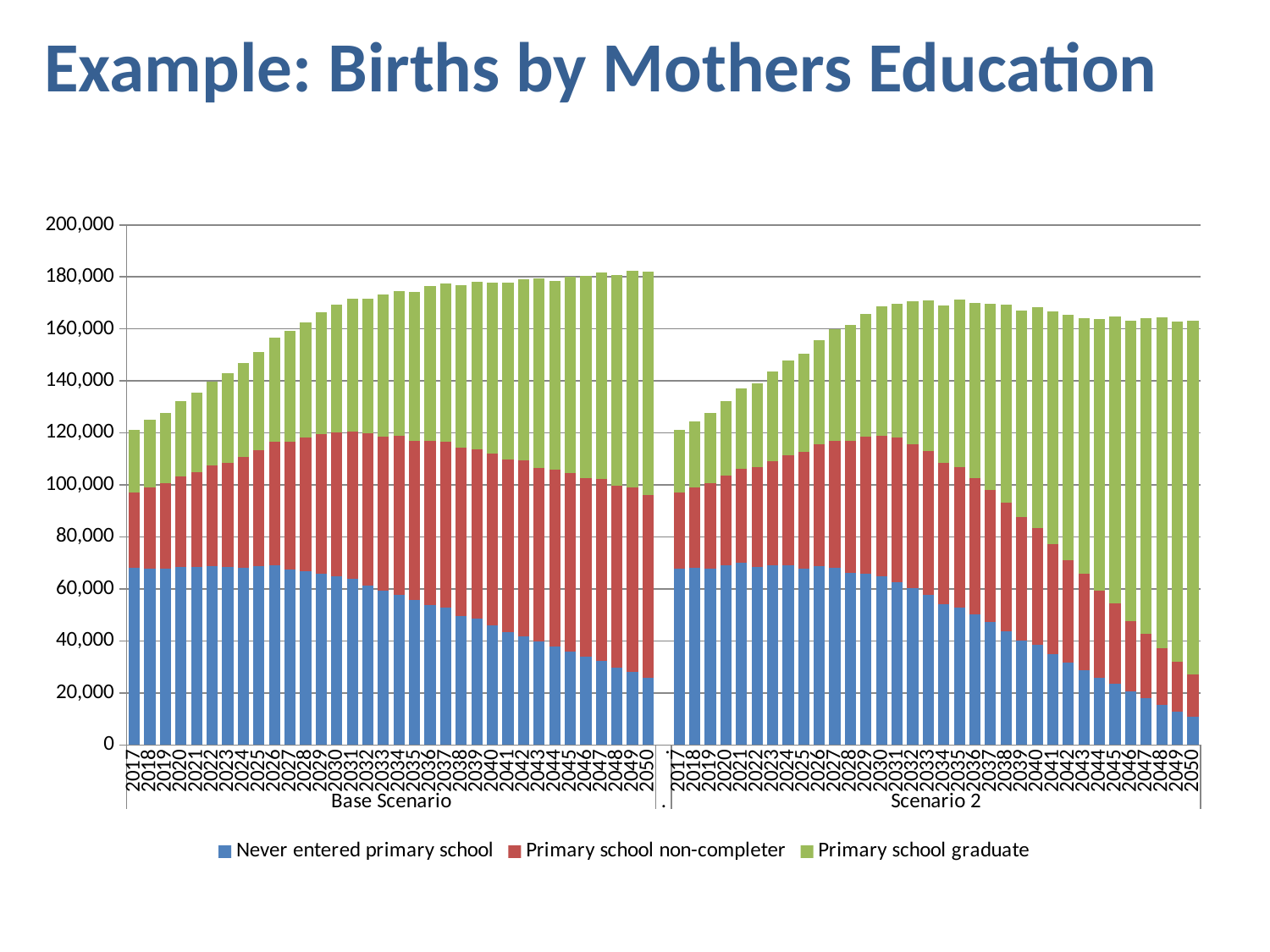
Does the Never entered primary school series in Scenario 2 rise or fall from 2030 to 2050? fall Does the total stacked value in the Base Scenario rise or fall from 2017 to 2030? rise What kind of chart is shown on the slide? Stacked bar chart How many years are plotted for the Base Scenario group? 34 Is the total stacked value for 2017 in Scenario 2 greater or less than 140,000? less Which has the larger total stacked value for 2050, the Base Scenario or Scenario 2? Base Scenario Which series is shown in green in the legend? Primary school graduate Is the Never entered primary school value for 2050 in the Base Scenario greater or less than 20,000? greater What are the two scenario groups labelled along the x axis? Base Scenario and Scenario 2 Is the total stacked value for 2050 in the Base Scenario greater or less than 160,000? greater How many series does the legend list? 3